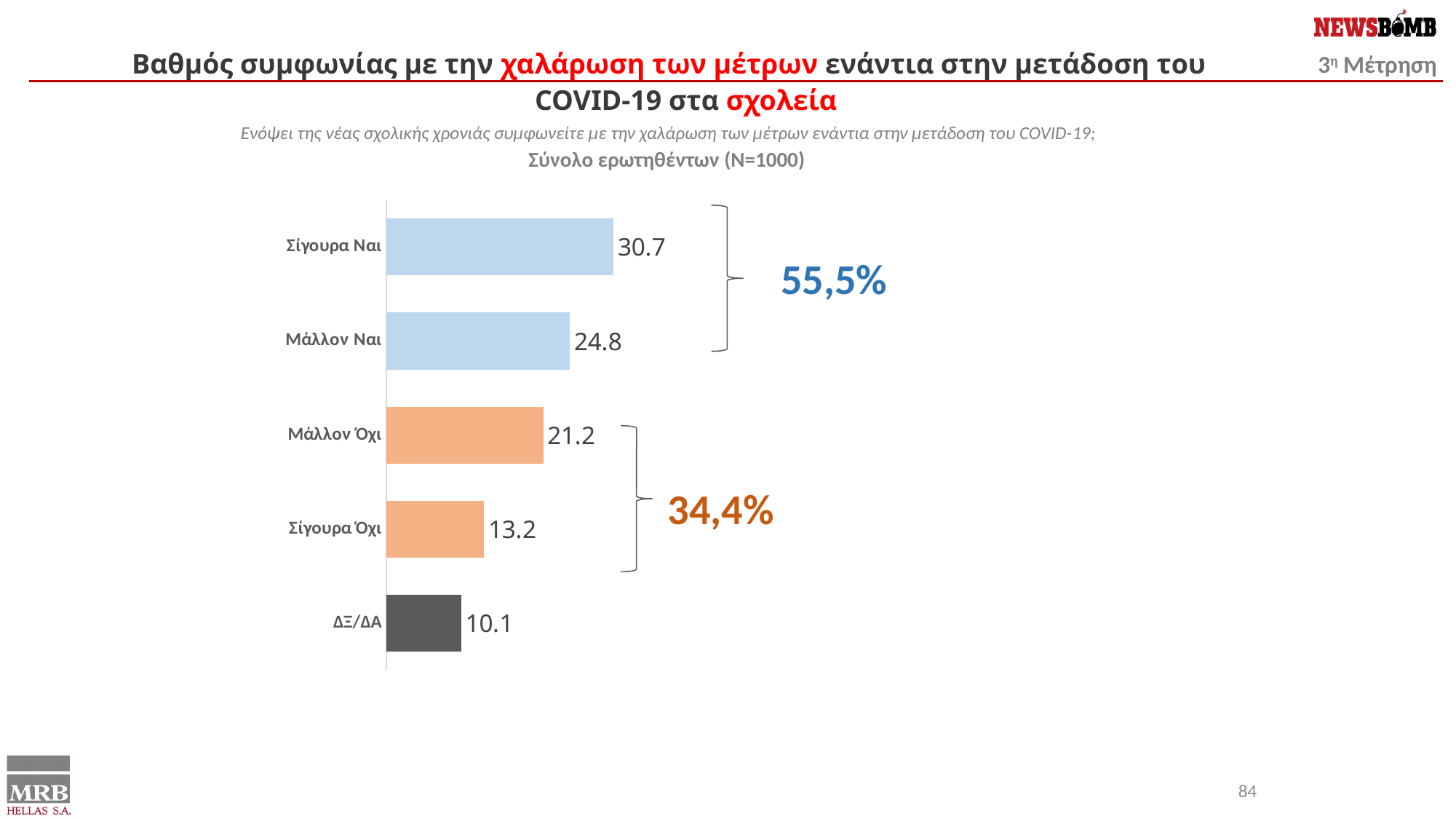
What is the value for ΔΞ/ΔΑ? 10.1 How many categories are shown in the chart? 5 What kind of chart is shown on the slide? Bar chart Which category has the highest value? Σίγουρα Ναι What combined percentage is shown next to the bracket grouping Σίγουρα Ναι and Μάλλον Ναι? 55,5% Which category has the lowest value? ΔΞ/ΔΑ What is the value for Μάλλον Ναι? 24.8 What is the difference between the values for Σίγουρα Ναι and Μάλλον Ναι? 5.9 What is the value for Σίγουρα Όχι? 13.2 What is the value for Μάλλον Όχι? 21.2 Which is larger, the value for Μάλλον Όχι or the value for Σίγουρα Όχι? Μάλλον Όχι What is the value for Σίγουρα Ναι? 30.7